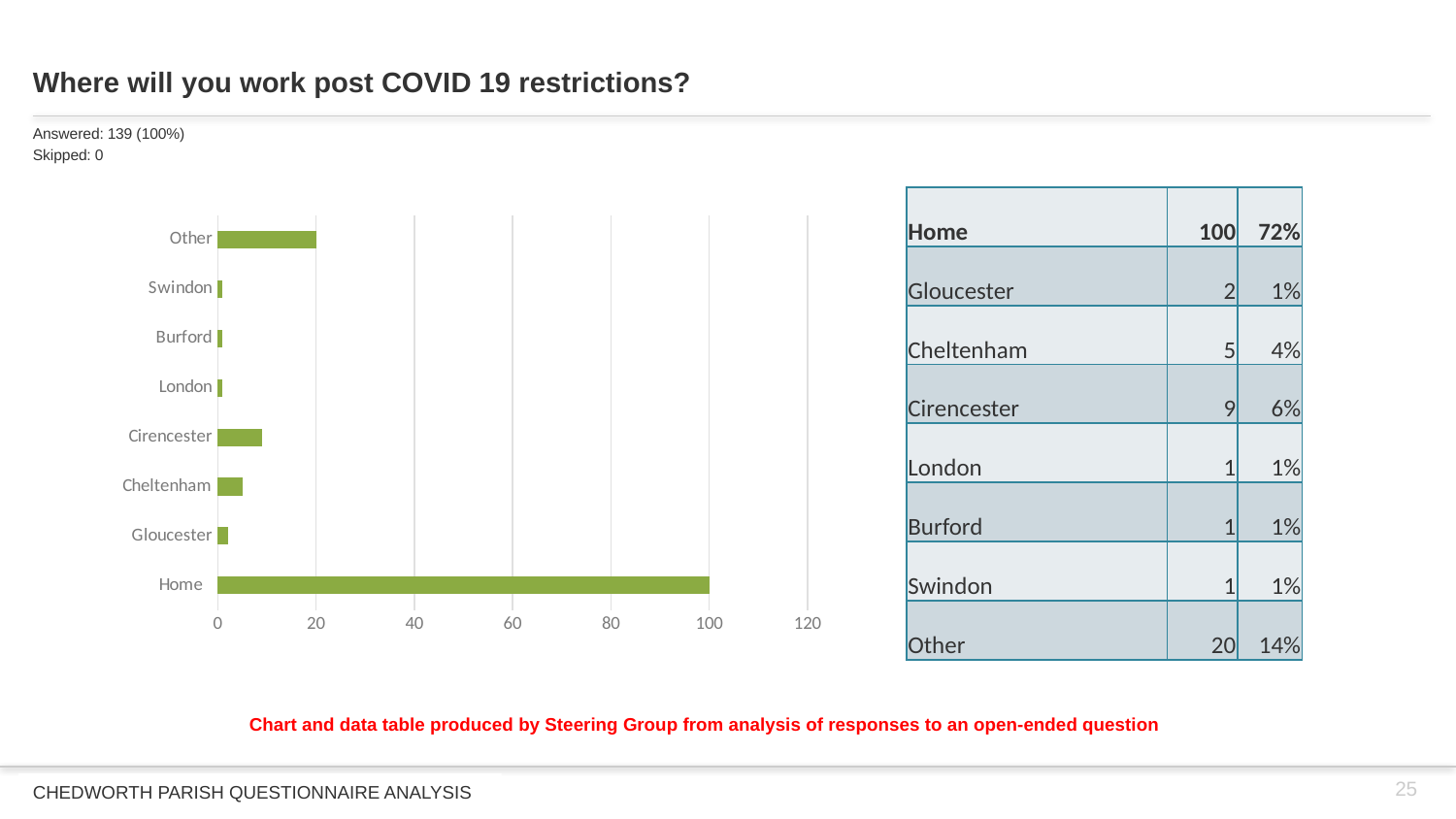
Which category has the highest value in the chart? Home What is the value for Other? 20 What kind of chart is shown on the slide? bar chart What is the difference between the values for Home and Other? 80 What is the value for Cheltenham? 5 What percentage does the data table give for Home? 72% What is the value for Cirencester? 9 What is the title of the slide's chart question? Where will you work post COVID 19 restrictions? What is the value for Home? 100 Which is larger, the value for Cirencester or the value for Cheltenham? Cirencester How many categories does the bar chart show? 8 Is the value for Home greater or less than 80? greater